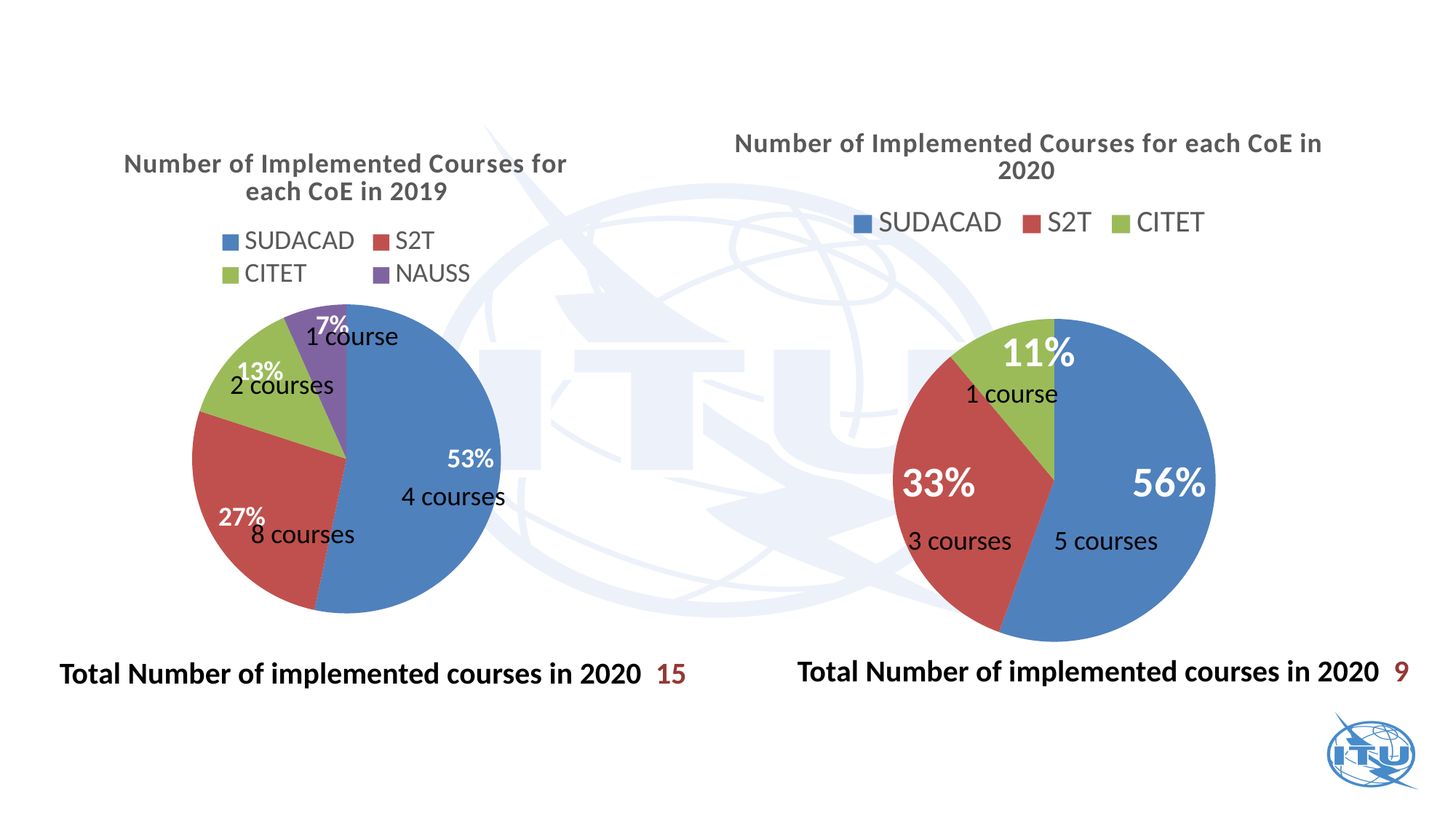
In the 2020 chart, how many courses did SUDACAD implement? 5 courses In the 2020 chart, what percentage share does S2T have? 33% Which CoE appears in the legend of the 2019 chart but not in the 2020 chart? NAUSS In the 2019 chart, which CoE has the largest slice? SUDACAD What kind of chart is the 'Number of Implemented Courses for each CoE in 2019' chart? Pie chart In the 2020 chart, how many more courses did SUDACAD implement than S2T? 2 courses How many entries does the legend of the 2020 chart list? 3 In the 2019 chart, which CoE has the smallest slice? NAUSS In the 2019 chart, what percentage share does SUDACAD have? 53% In the 2019 chart, what percentage share does NAUSS have? 7% How many CoEs (slices) are shown in the 2019 chart? 4